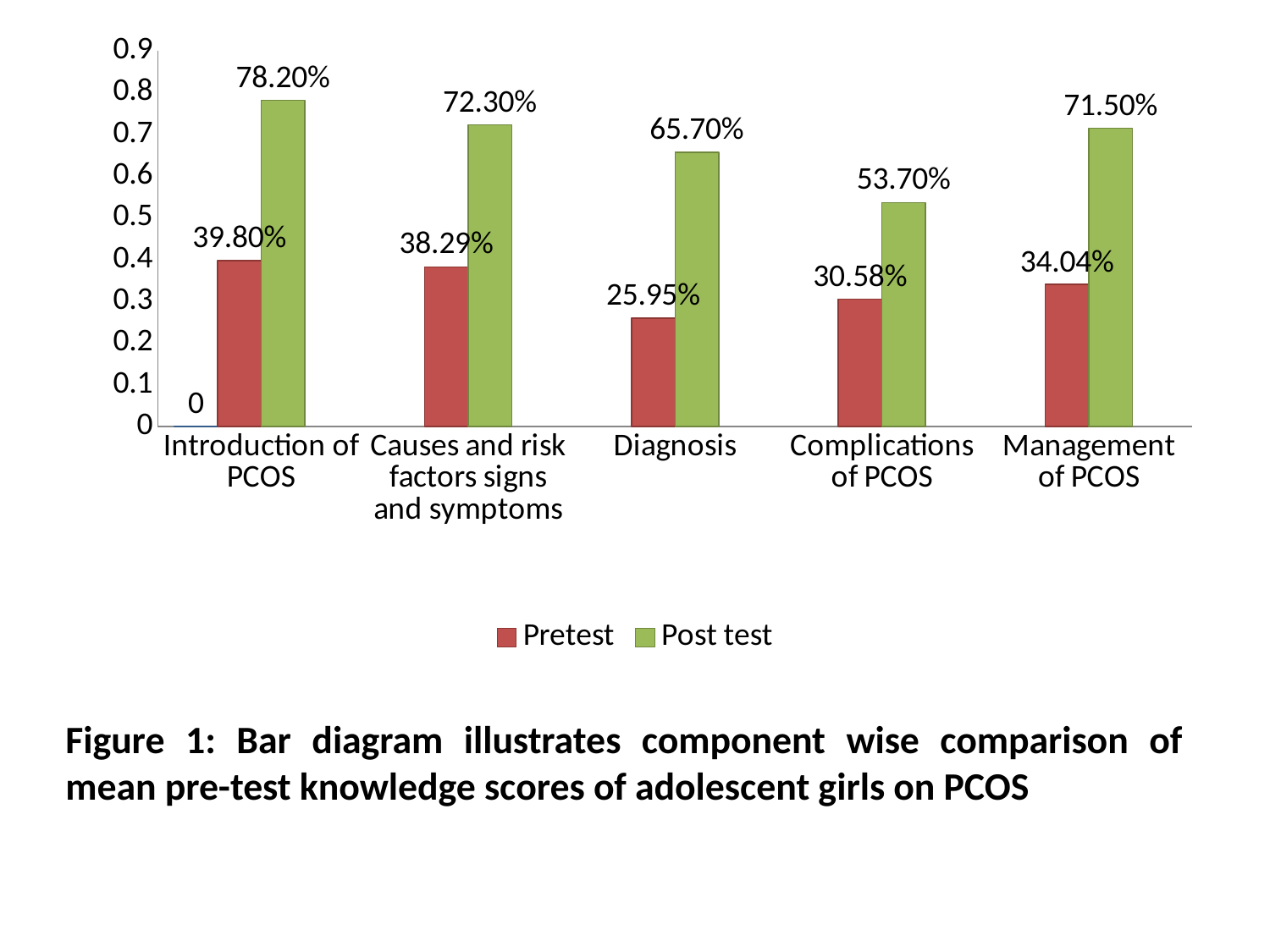
What colour represents the Post test series in the legend? green Which has the larger Pretest value: Causes and risk factors signs and symptoms or Management of PCOS? Causes and risk factors signs and symptoms What is the difference between the Post test and Pretest values for Introduction of PCOS? 38.40% What is the difference between the Post test and Pretest values for Management of PCOS? 37.46% Which category has the highest Post test value? Introduction of PCOS Which category has the lowest Pretest value? Diagnosis What is the Pretest value for Complications of PCOS? 30.58% How many categories are shown on the x axis? 5 What kind of chart is shown on the slide? bar chart Is the Post test bar for Complications of PCOS greater or less than 0.5 on the axis? greater How many series does the legend list? 2 What is the Post test value for Diagnosis? 65.70%